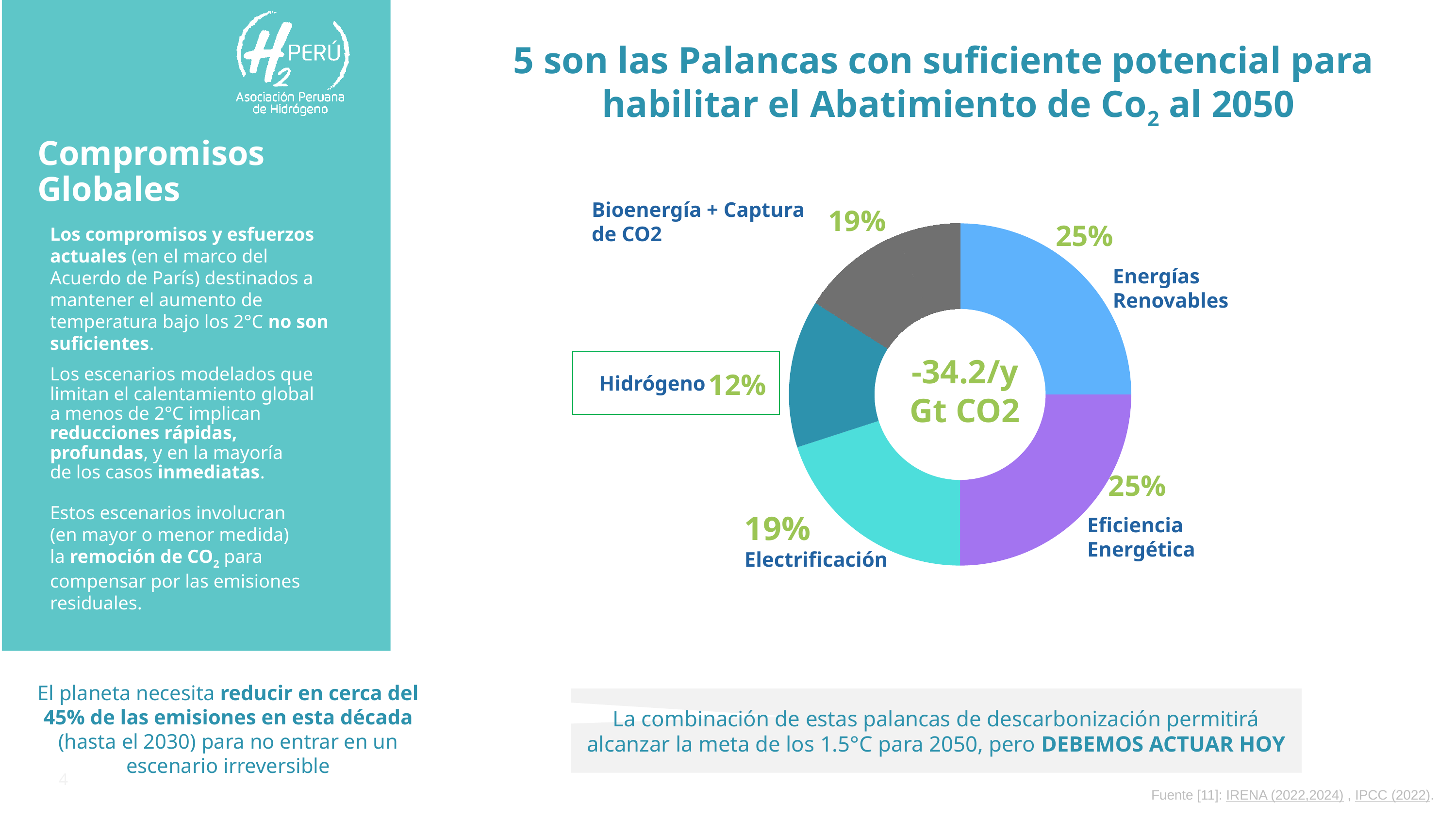
How many categories (segments) does the donut chart show? 5 What percentage is shown for Eficiencia Energética? 25% What kind of chart is shown on the slide? Donut (pie) chart What share of the donut chart is labelled for Hidrógeno? 12% What percentage is shown for Bioenergía + Captura de CO2? 19% Which category's label is enclosed in a green box on the chart? Hidrógeno Which category has the smallest share in the donut chart? Hidrógeno What value is printed in the centre of the donut chart? -34.2/y Gt CO2 What percentage is shown for Electrificación? 19% What is the difference in percentage points between Eficiencia Energética and Hidrógeno? 13 percentage points What percentage is shown for Energías Renovables? 25% Which is larger, the share for Electrificación or the share for Hidrógeno? Electrificación